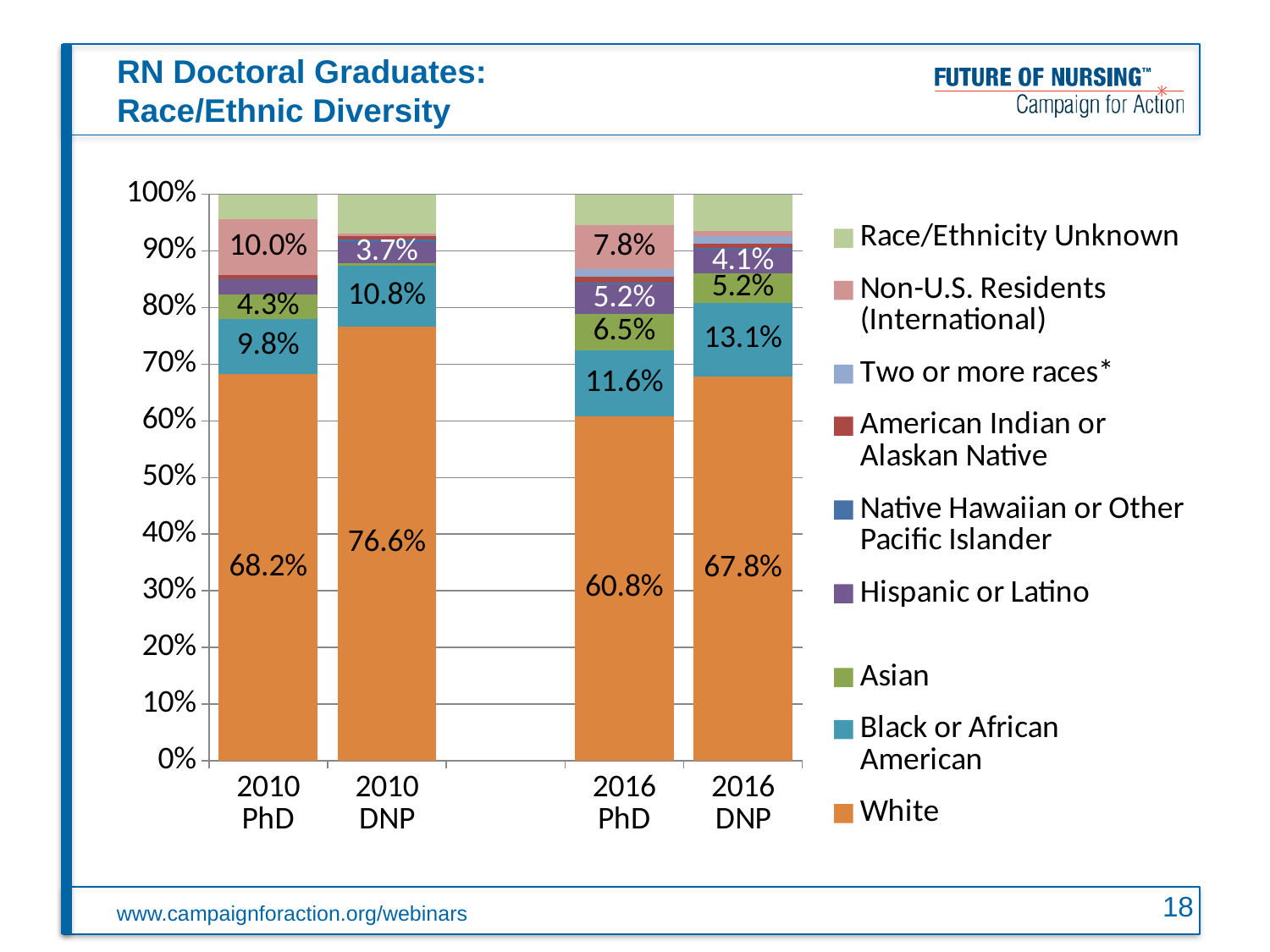
What is the difference between the White share of 2010 PhD graduates and 2016 PhD graduates? 7.4% How many series does the legend list? 9 Which bar has the highest percentage of White graduates? 2010 DNP Did the White share of PhD graduates rise or fall from 2010 to 2016? Fall What percentage of 2016 DNP graduates were Black or African American? 13.1% What share of 2016 PhD graduates were Non-U.S. Residents (International)? 7.8% What percentage of 2010 DNP graduates were Hispanic or Latino? 3.7% How many bars are shown in the chart? 4 Which bar has the lowest percentage of White graduates? 2016 PhD Which is larger: the Asian share of 2016 PhD graduates or of 2016 DNP graduates? 2016 PhD What kind of chart is shown on the slide? Stacked bar chart What percentage of 2010 PhD RN doctoral graduates were White? 68.2%